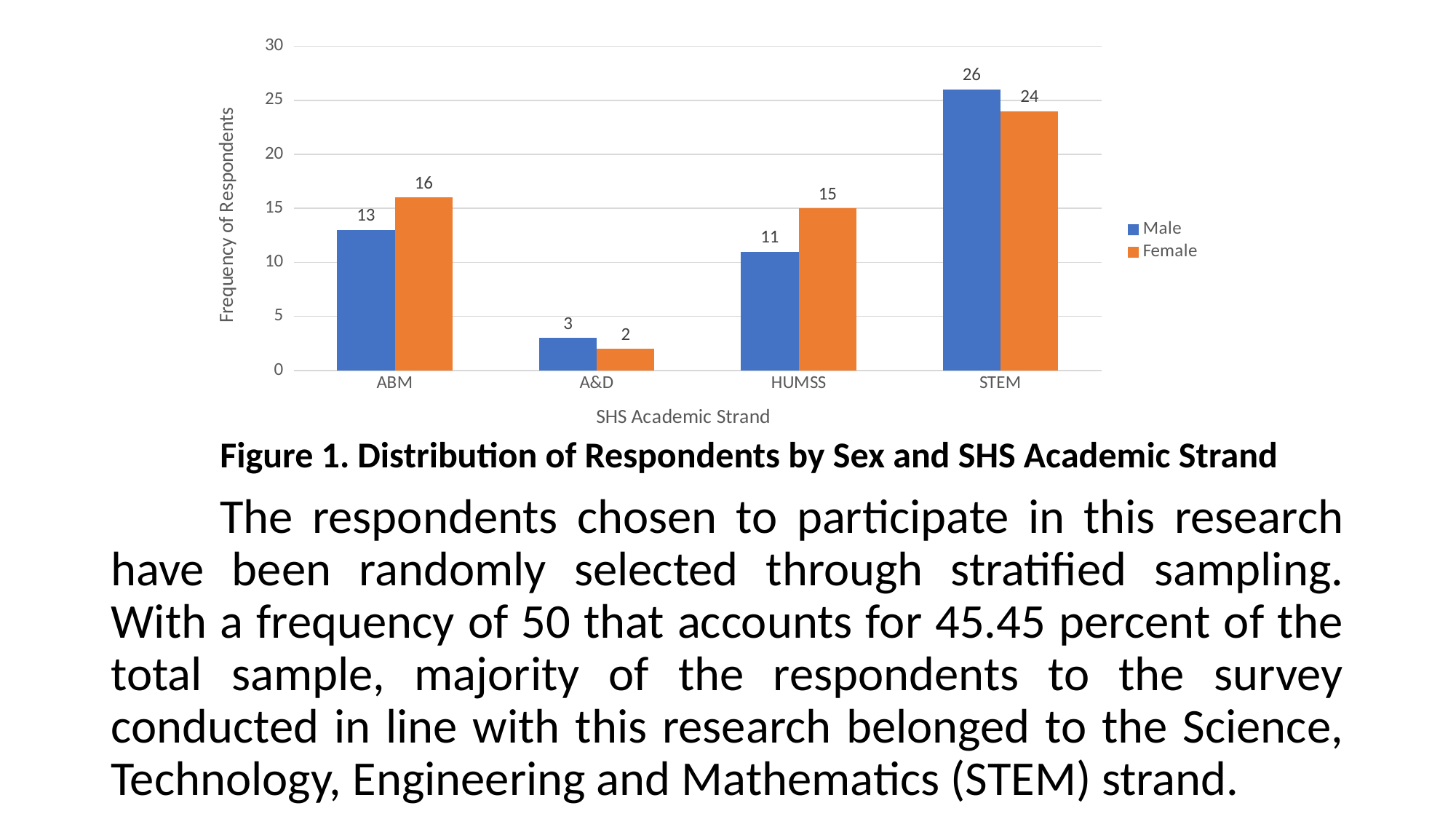
What is the Male value for STEM? 26 What is the Male value for HUMSS? 11 What is the label of the y axis? Frequency of Respondents Which is larger for HUMSS, the Male value or the Female value? Female What is the difference between the Male and Female values for STEM? 2 Which academic strand has the highest Female value? STEM What is the Female value for ABM? 16 Is the Male value for ABM greater or less than 10? greater Which academic strand has the lowest Male value? A&D How many academic strands are shown on the x axis? 4 What kind of chart is shown on the slide? bar chart How many series does the legend list? 2